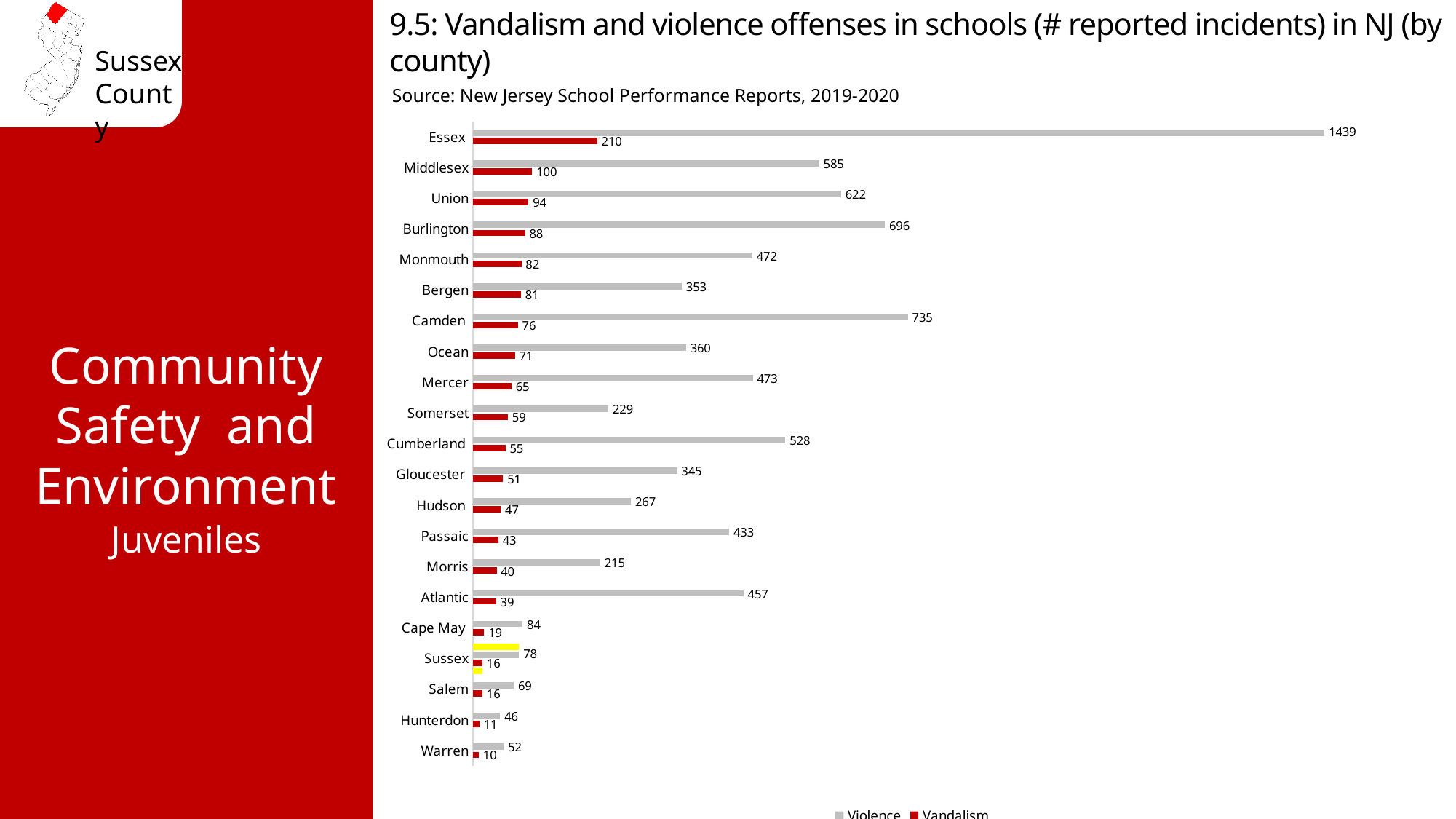
What is the combined total of violence and vandalism incidents for Sussex County? 94 Which county has the lowest number of reported vandalism incidents? Warren How many series does the legend list? 2 How many counties are shown in the chart? 21 What is the number of reported vandalism incidents for Essex County? 210 What is the number of reported violence incidents for Sussex County? 78 Which county has the lowest number of reported violence incidents? Hunterdon Which county's bars are highlighted in yellow on the chart? Sussex What is the difference between the violence incidents in Essex and Camden? 704 Which county has more reported violence incidents, Union or Middlesex? Union Which county has the highest number of reported violence incidents? Essex What kind of chart is shown on the slide? Bar chart